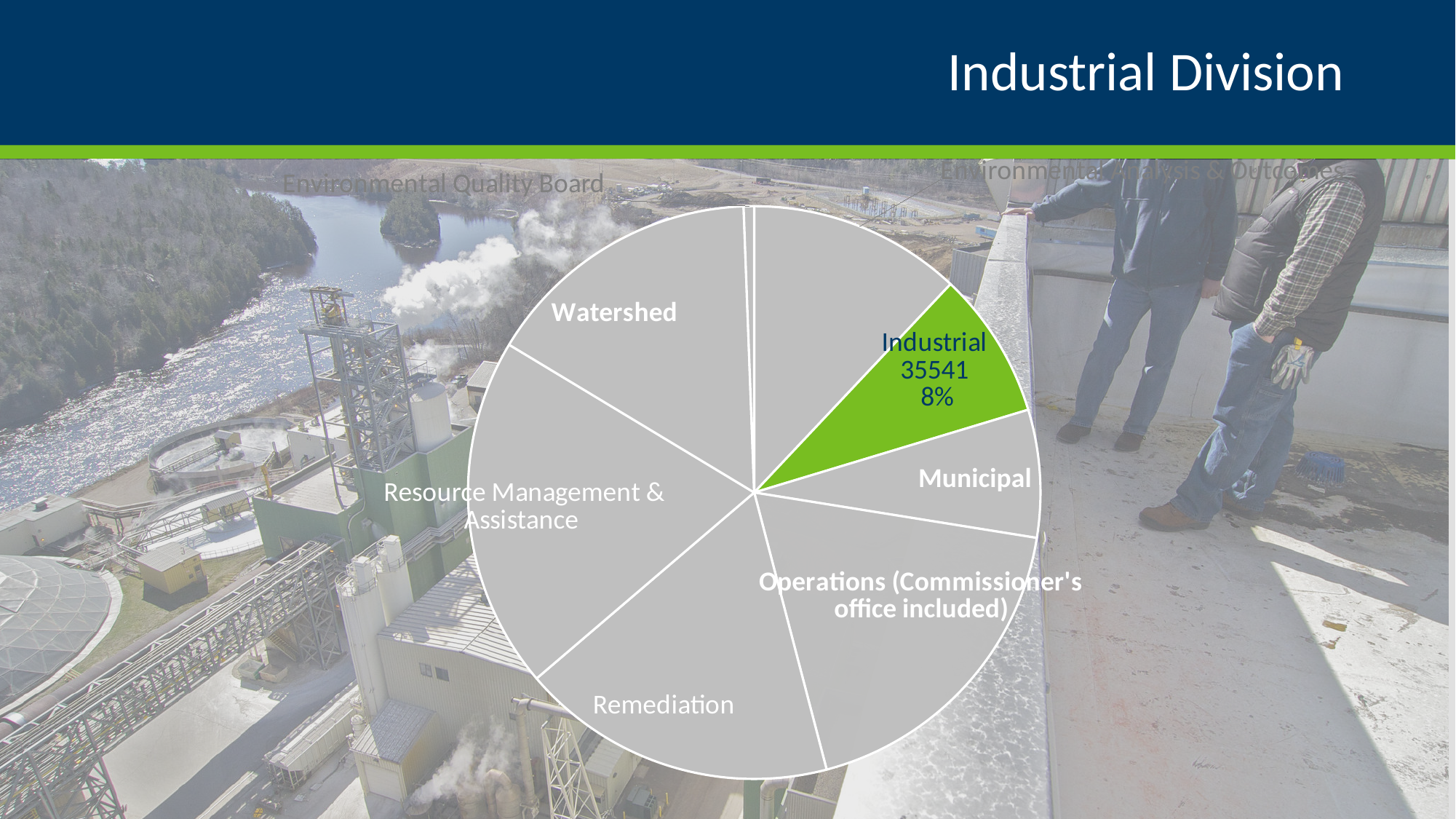
What is the value shown for the Industrial slice? 35541 What share of the pie does the Industrial slice represent? 8% What type of chart is shown on the slide? pie chart Which slice of the pie is highlighted in green? Industrial Which slice is larger, Remediation or Industrial? Remediation Which slice of the pie is the smallest? Environmental Quality Board Is the Industrial slice's share of the pie greater or less than 10%? less What is the title of the slide containing the pie chart? Industrial Division Which slice is larger, Industrial or Municipal? Industrial Which slice is larger, Operations (Commissioner's office included) or Municipal? Operations (Commissioner's office included)